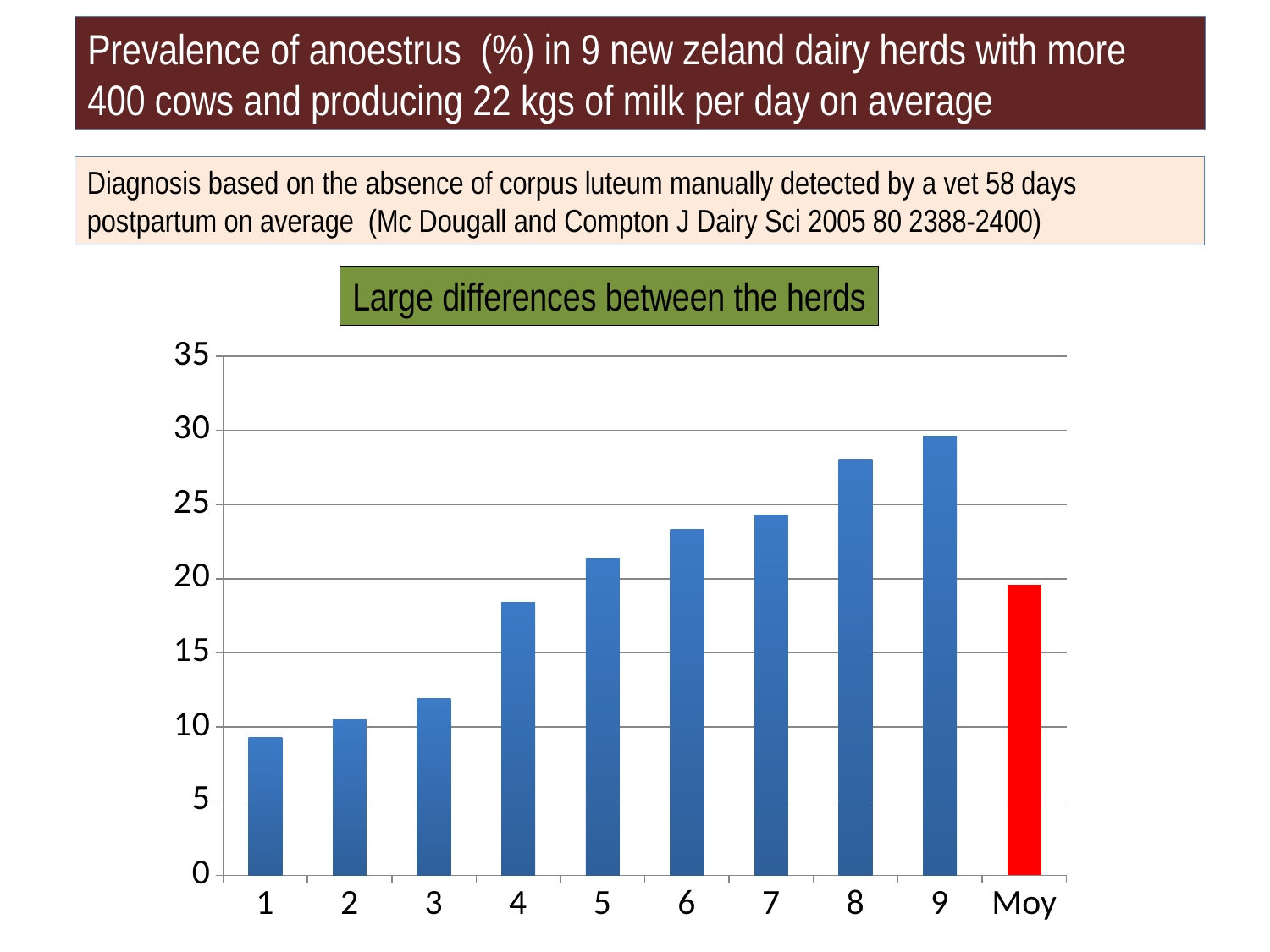
Is the value for herd 6 greater or less than 25? less Is the value for herd 1 greater or less than 10? less Which herd has the lowest prevalence of anoestrus? 1 Do the values rise or fall from herd 1 to herd 9? rise Is the value for herd 8 greater or less than 25? greater What colour is the bar for Moy? red What kind of chart is shown on the slide? bar chart Which herd has the highest prevalence of anoestrus? 9 Which is larger, the value for herd 8 or the value for herd 4? herd 8 How many bars are plotted on the chart? 10